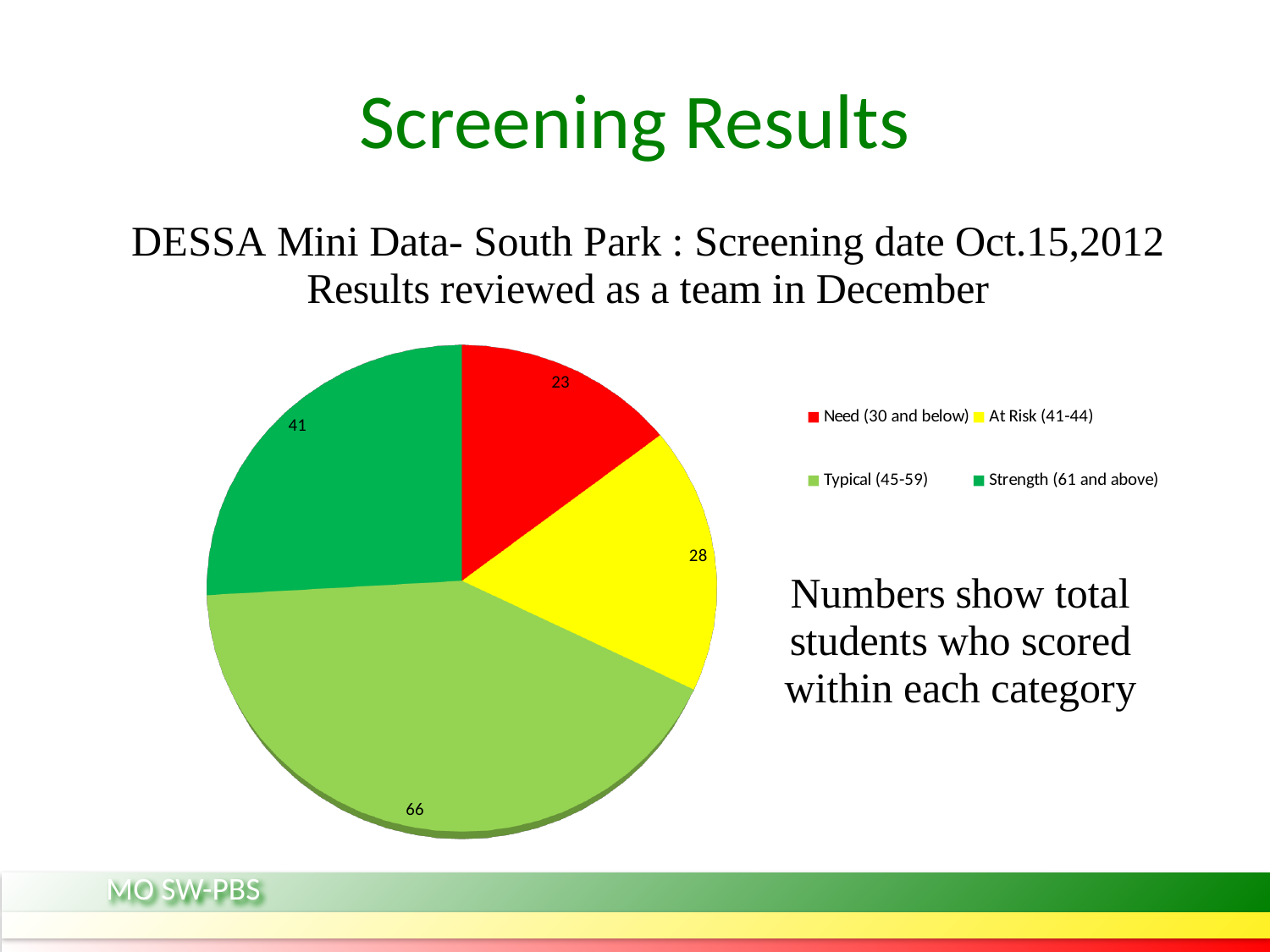
How many categories does the pie chart show? 4 How many students scored in the At Risk (41-44) category? 28 What is the total number of students across all four categories in the pie chart? 158 What is the difference between the number of students in the Typical (45-59) category and the Strength (61 and above) category? 25 How many students scored in the Typical (45-59) category? 66 What colour is the slice for the Need (30 and below) category? Red Which category has more students: At Risk (41-44) or Need (30 and below)? At Risk (41-44) How many students scored in the Need (30 and below) category? 23 What type of chart is shown on the slide? Pie chart Which category has the smallest number of students? Need (30 and below) Which category has the largest number of students? Typical (45-59) How many students scored in the Strength (61 and above) category? 41